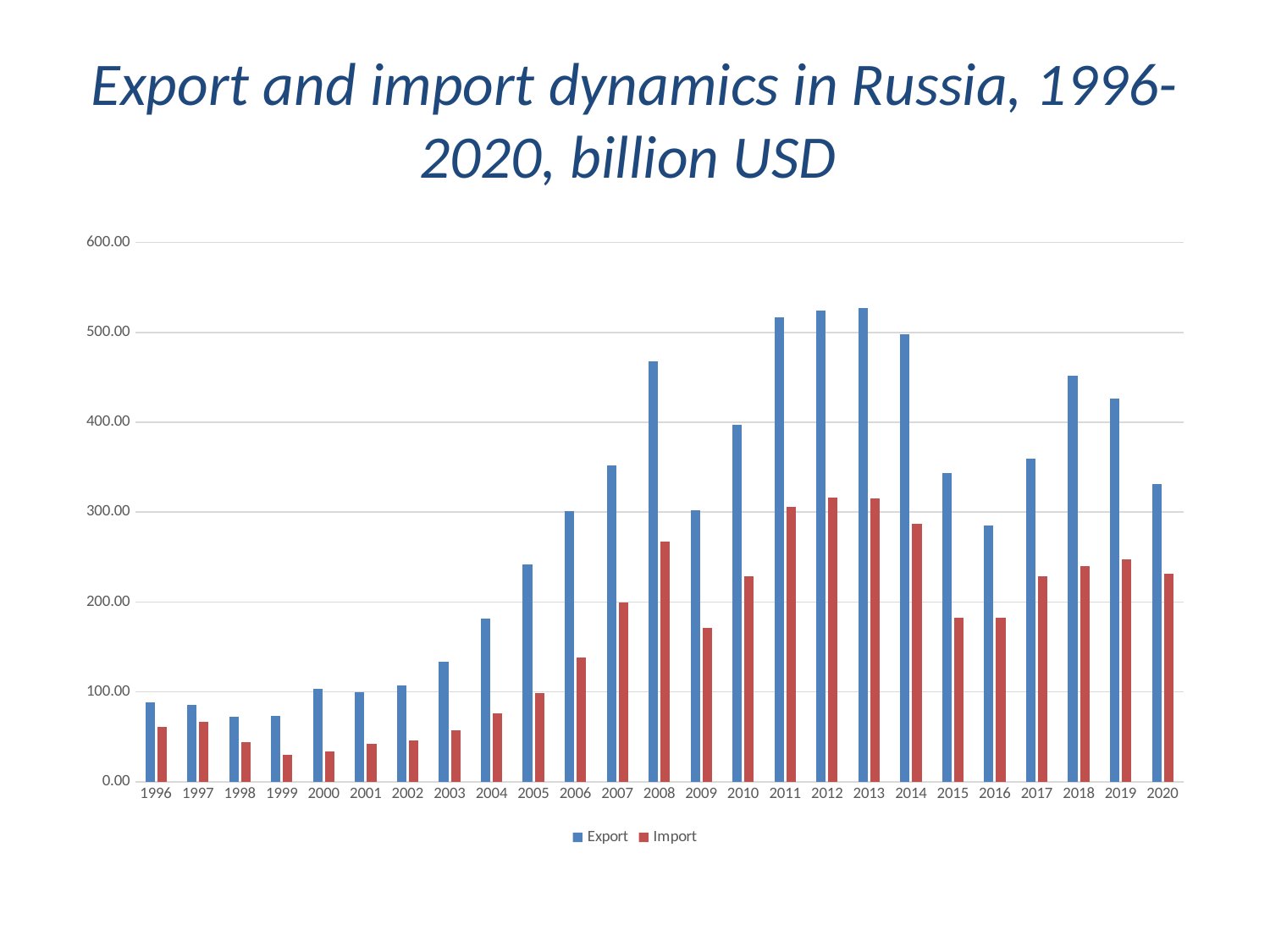
Which is larger, the Export value for 2008 or for 2009? 2008 How many series does the legend list? 2 Do the Export values rise or fall from 2004 to 2008? rise Is the Import value for 2019 greater or less than 200.00? greater Is the Export value for 2016 greater or less than 300.00? less Is the Export value for 2015 greater or less than 400.00? less What colour are the Import bars? red How many years are shown on the x axis? 25 What kind of chart is shown on the slide? bar chart Which is larger, the Import value for 2016 or for 2018? 2018